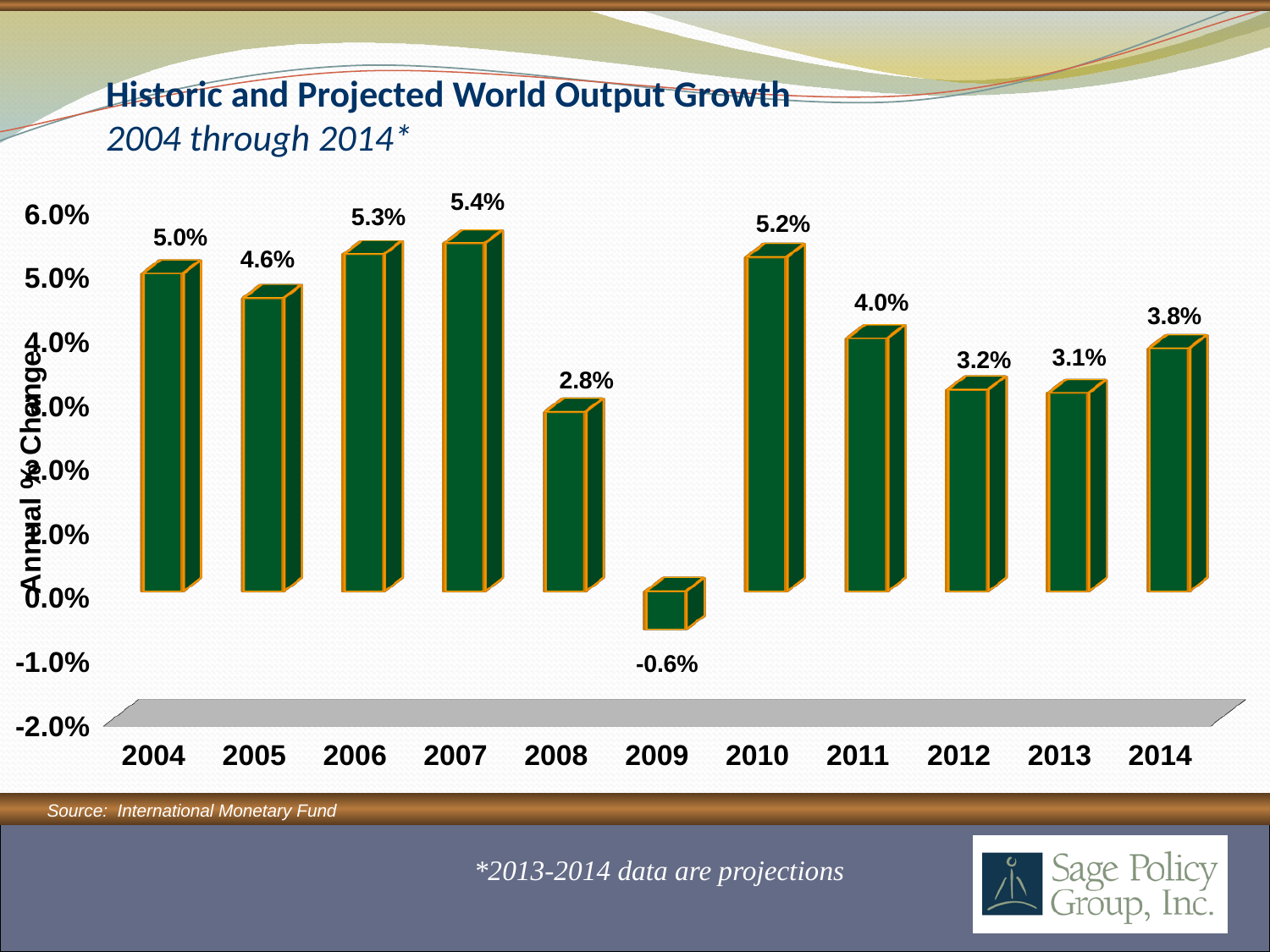
What kind of chart is shown on the slide? bar chart What is the source of the data cited on the slide? International Monetary Fund Is the value for 2008 greater or less than 3.0%? less Which year had higher world output growth, 2005 or 2006? 2006 How many years are shown on the x axis? 11 What was world output growth in 2009? -0.6% Which year had the lowest world output growth? 2009 What was world output growth in 2007? 5.4% What is the difference between world output growth in 2010 and 2011? 1.2% Do the values rise or fall from 2011 to 2013? fall What is the projected world output growth for 2014? 3.8% Which year had the highest world output growth? 2007